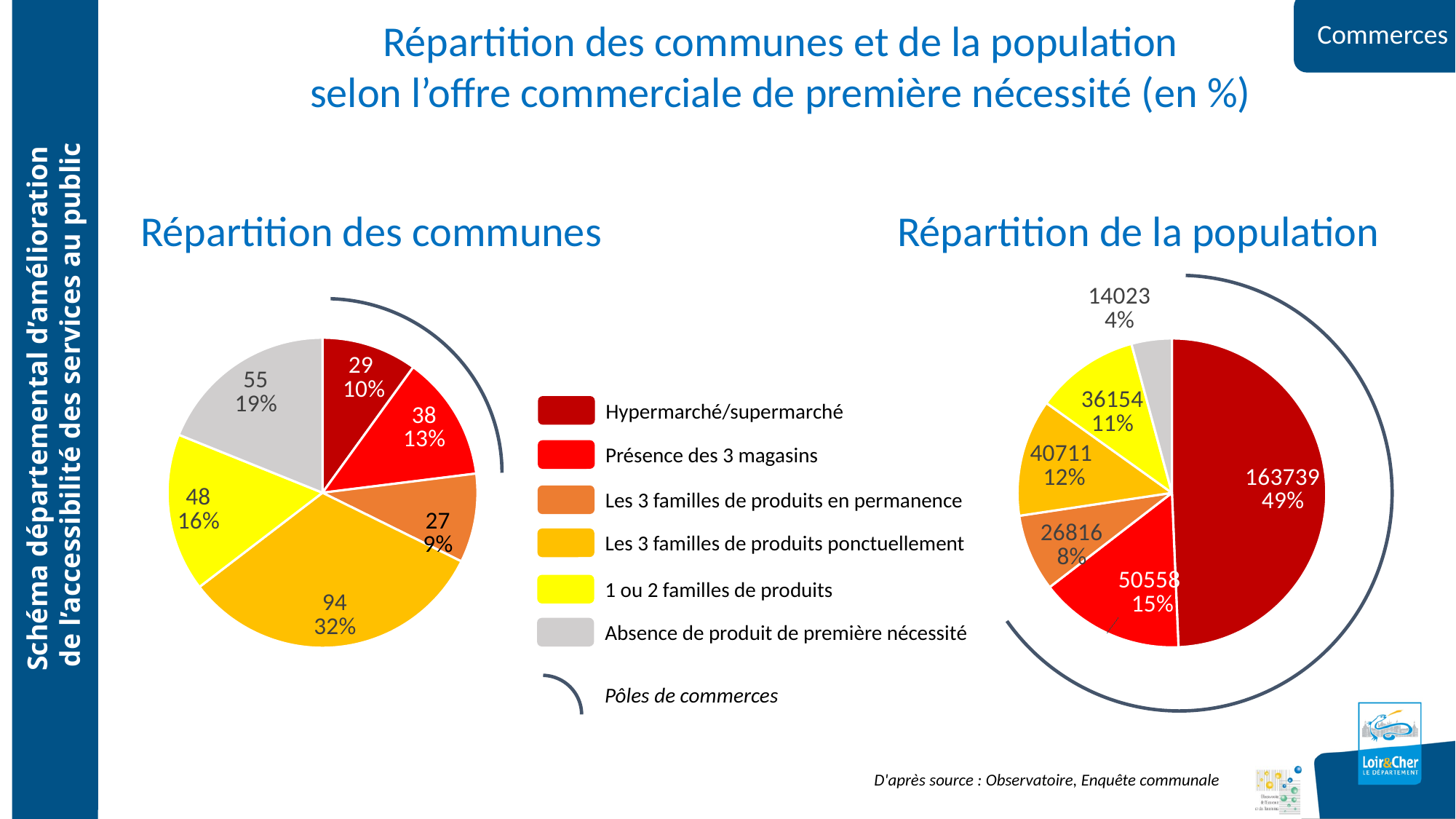
Which colour represents 'Absence de produit de première nécessité' in the legend? grey In the 'Répartition des communes' chart, what is the difference between the number of communes with '1 ou 2 familles de produits' and those with 'Hypermarché/supermarché'? 19 How many categories does the legend list? 6 In the 'Répartition des communes' chart, which category has the smallest slice? Les 3 familles de produits en permanence In the 'Répartition de la population' chart, what is the population value for 'Hypermarché/supermarché'? 163739 In the 'Répartition de la population' chart, which is larger: the population for 'Les 3 familles de produits ponctuellement' or for '1 ou 2 familles de produits'? Les 3 familles de produits ponctuellement What kind of chart is used for 'Répartition des communes'? pie chart In the 'Répartition des communes' chart, how many communes are in the 'Les 3 familles de produits ponctuellement' slice? 94 In the 'Répartition des communes' chart, which category has the largest slice? Les 3 familles de produits ponctuellement In the 'Répartition de la population' chart, what share of the population is in the 'Présence des 3 magasins' slice? 15% In the 'Répartition de la population' chart, which category has the smallest slice? Absence de produit de première nécessité In the 'Répartition des communes' chart, what share of communes have 'Absence de produit de première nécessité'? 19%